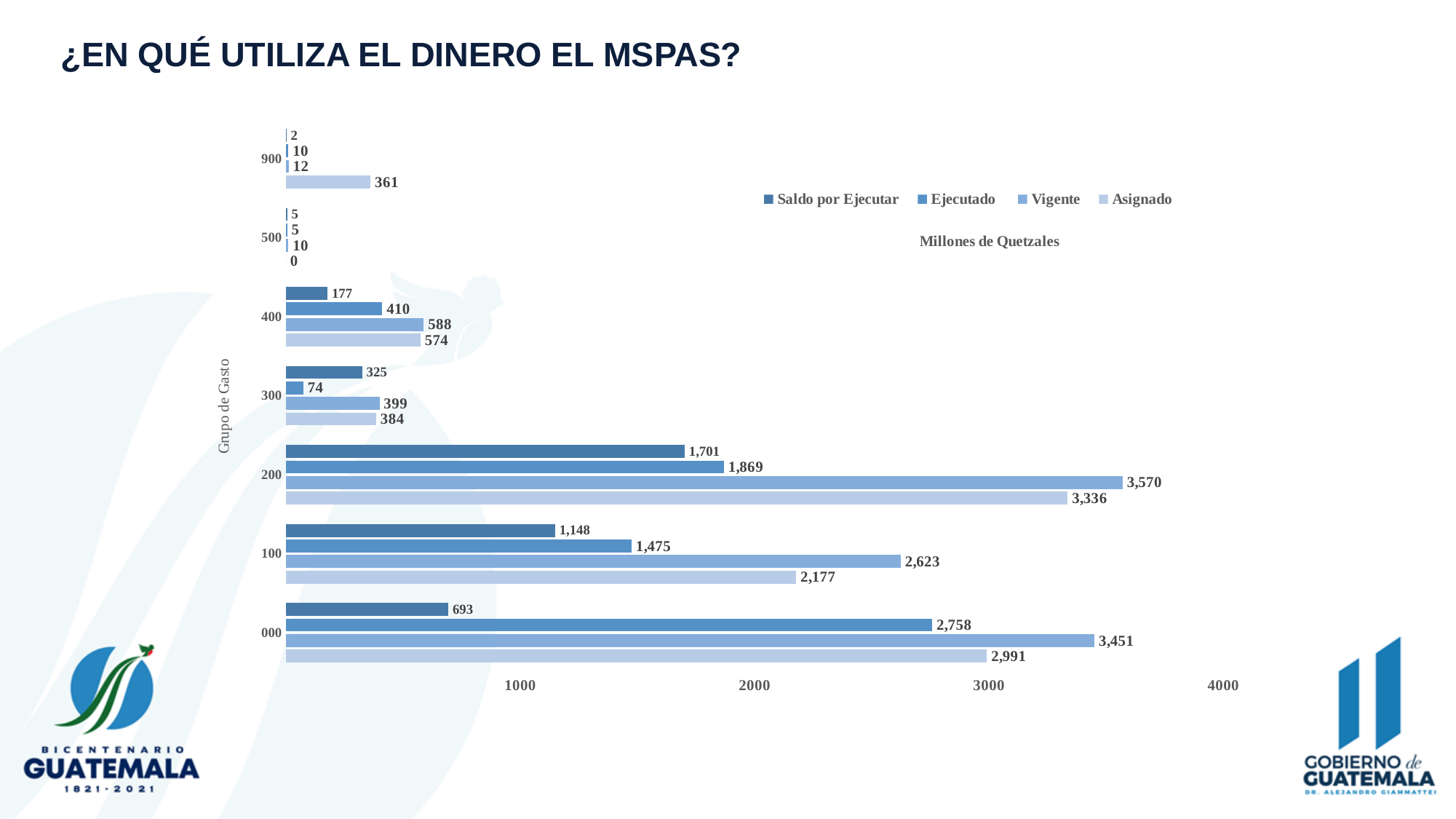
What is the difference between the Vigente and Ejecutado values for group 100? 1,148 Is the Asignado value for group 000 greater or less than 3000? less What unit is stated for the values in the chart? Millones de Quetzales How many series does the legend list? 4 How many expense groups (Grupo de Gasto) are shown on the y axis? 7 What is the Asignado value for group 900? 361 What is the Ejecutado value for group 000? 2,758 Which is larger for group 300: Saldo por Ejecutar or Ejecutado? Saldo por Ejecutar Which group has the highest Saldo por Ejecutar value? 200 What is the Vigente value for group 200? 3,570 Which group has the lowest Asignado value? 500 What kind of chart is shown on the slide? Bar chart